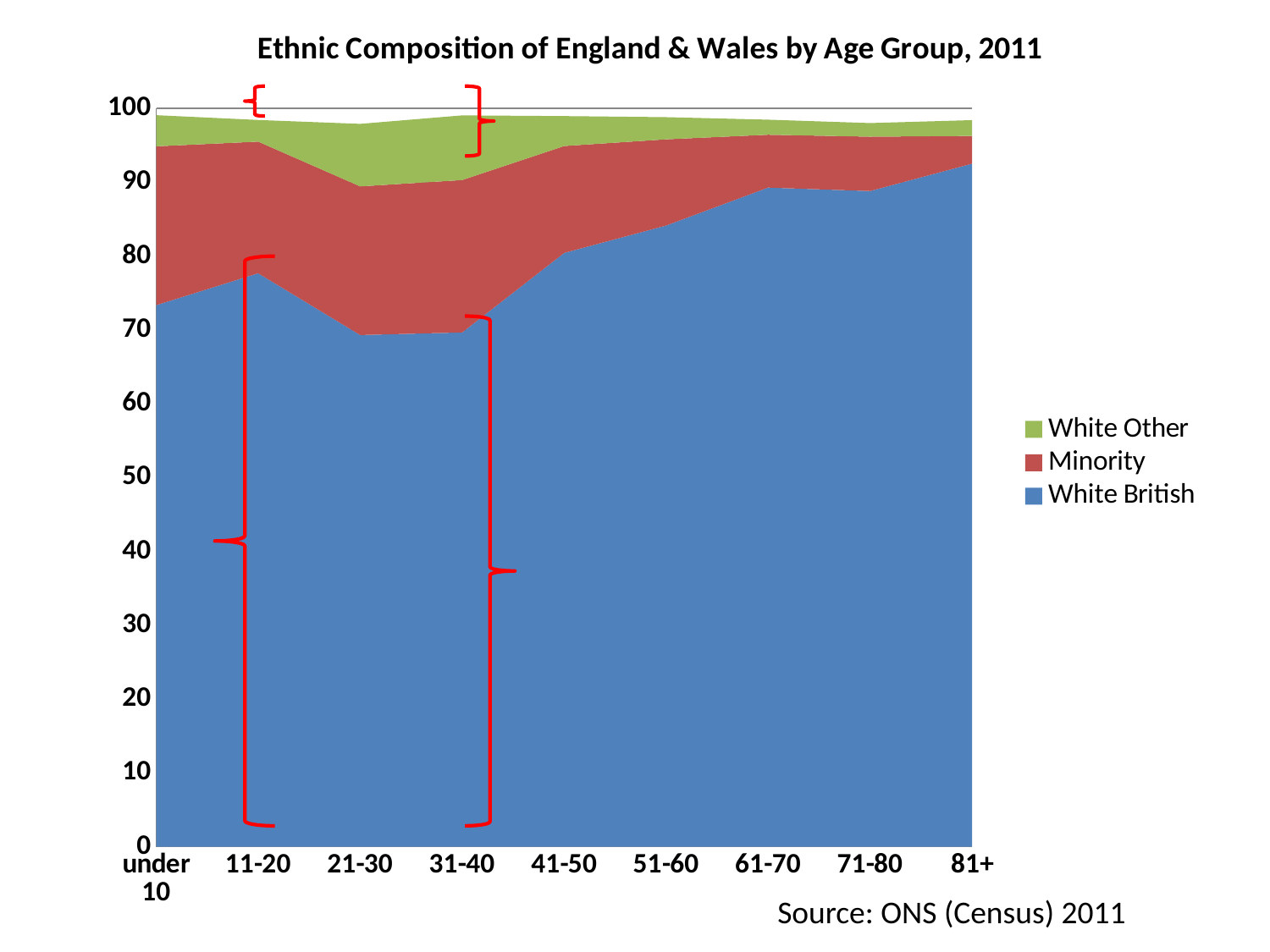
Which series is shown in green? White Other Is the White British value for the under 10 age group greater or less than 70? greater What is the title of the chart? Ethnic Composition of England & Wales by Age Group, 2011 How many age groups are shown along the x axis? 9 Which age group has the highest White British share? 81+ How many series does the legend list? 3 What kind of chart is shown on the slide? Stacked area chart Which is larger, the White British share for 81+ or for 21-30? 81+ Is the White British value for the 51-60 age group greater or less than 80? greater Is the White British value for the 11-20 age group greater or less than 80? less Does the White British share rise or fall from the 31-40 age group to the 81+ age group? rise